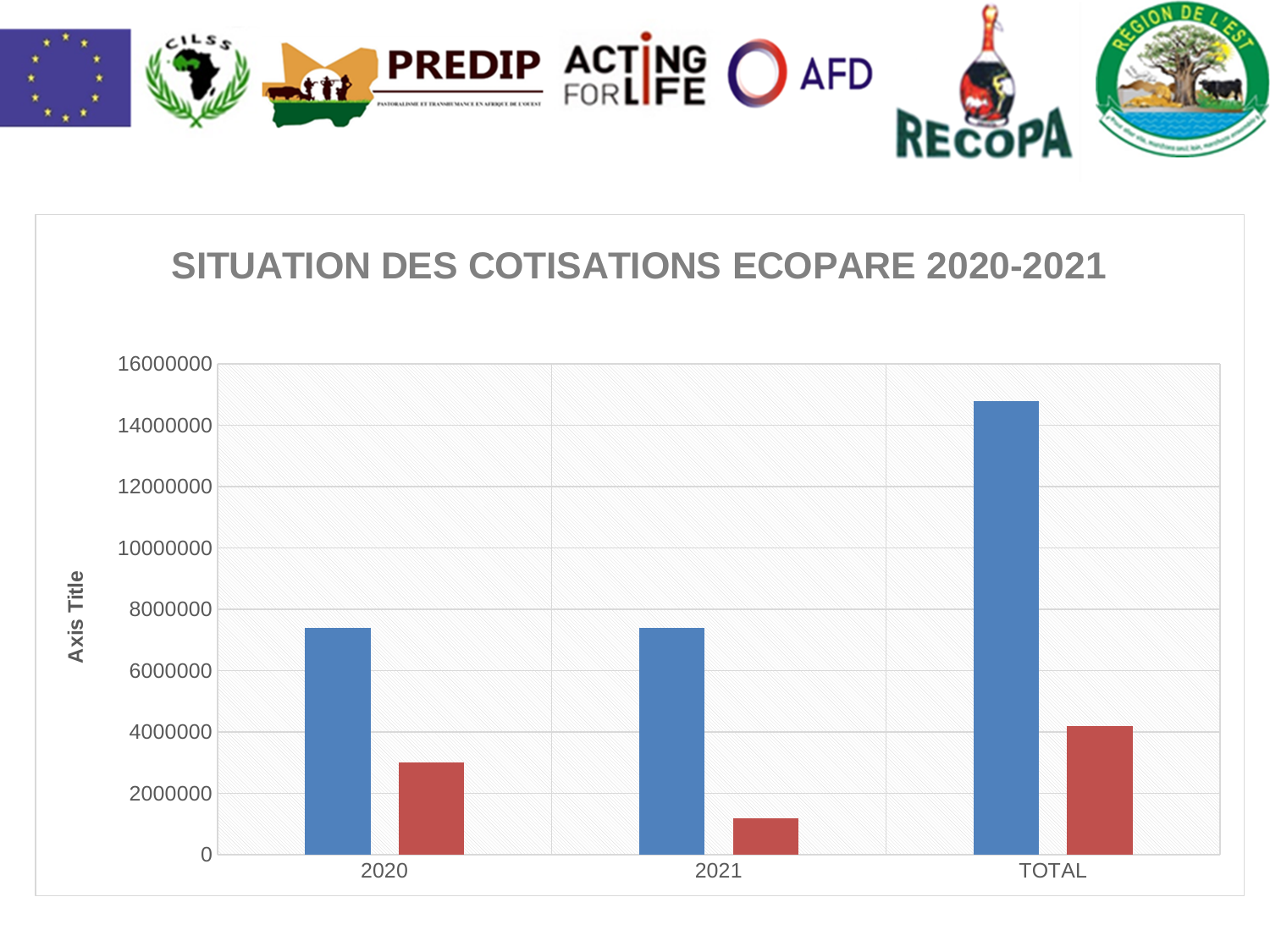
What is the label shown on the vertical axis of the chart? Axis Title How many categories are shown on the x axis of the chart? 3 Which bar in the chart is the tallest? the blue bar for TOTAL Is the value of the blue bar for 2020 greater or less than 6000000? greater For 2020, which is larger, the blue bar or the red bar? the blue bar Which bar in the chart is the shortest? the red bar for 2021 Is the value of the red bar for 2021 greater or less than 2000000? less What is the title of the chart? SITUATION DES COTISATIONS ECOPARE 2020-2021 What kind of chart is shown on the slide? bar chart Which red bar is larger, the one for 2020 or the one for 2021? 2020 Is the value of the blue bar for TOTAL greater or less than 14000000? greater